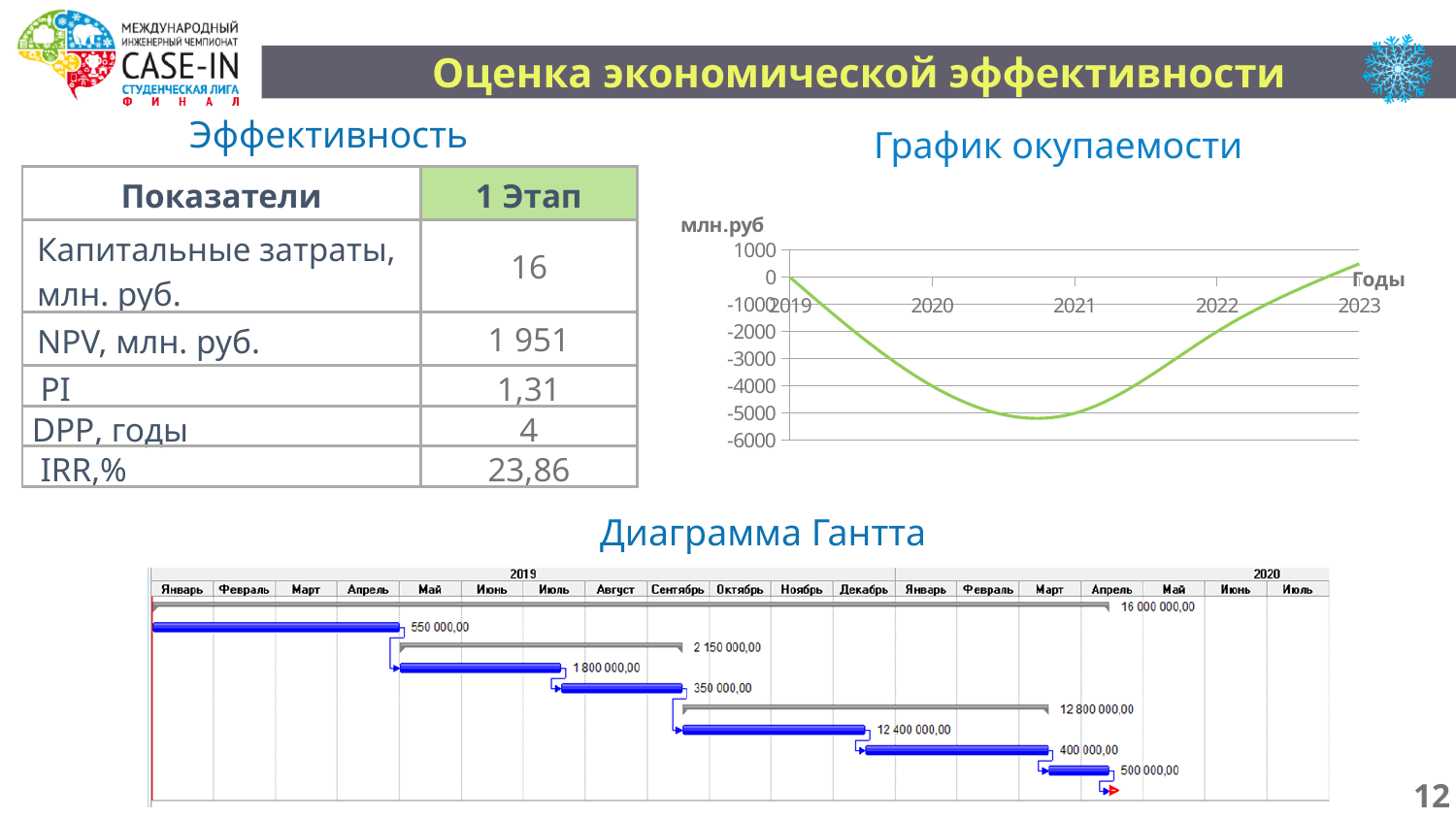
On the 'Диаграмма Гантта' chart, what is the largest value labeled on a bar? 16 000 000,00 On the 'График окупаемости' chart, what is the label of the horizontal axis? Годы On the 'График окупаемости' chart, what is the unit label shown on the vertical axis? млн.руб On the 'График окупаемости' chart, is the value for 2023 greater or less than 0? greater On the 'Диаграмма Гантта' chart, what is the smallest value labeled on a bar? 350 000,00 On the 'График окупаемости' chart, which is higher, the value for 2020 or the value for 2022? 2022 On the 'График окупаемости' chart, is the value for 2020 greater or less than -2000? less On the 'График окупаемости' chart, does the line first fall and then rise, or first rise and then fall, from 2019 to 2023? first falls, then rises What kind of chart is the 'График окупаемости' chart? line chart How many year ticks are shown on the x axis of the 'График окупаемости' chart? 5 On the 'Диаграмма Гантта' chart, which two years are shown in the timeline header? 2019 and 2020 On the 'График окупаемости' chart, is the value for 2021 greater or less than -4000? less